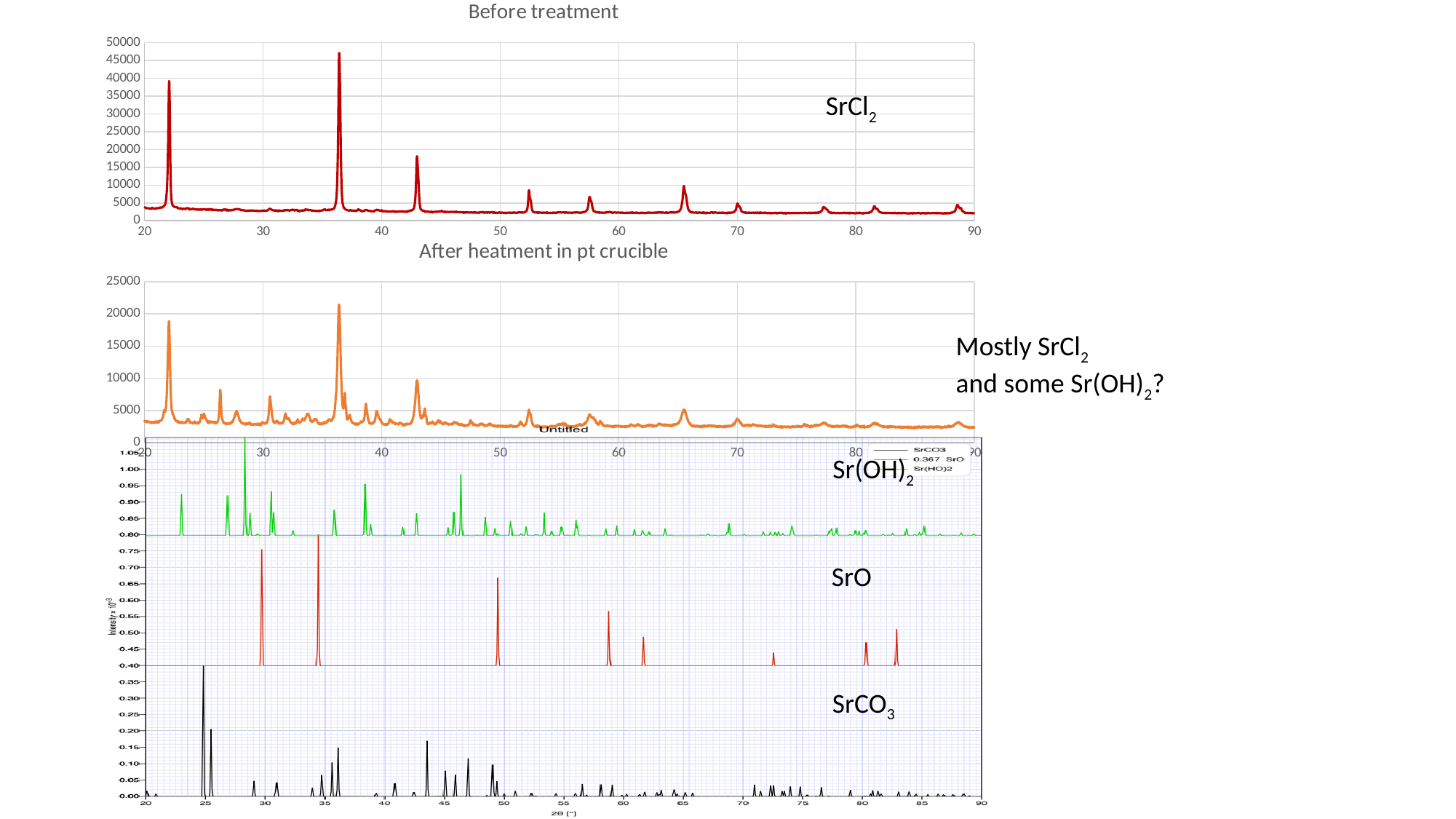
What is the title of the top chart on the slide? Before treatment In the bottom reference-pattern chart, how many compounds are listed in the legend? 3 In the 'After heatment in pt crucible' chart, is the value of the peak near 22 on the x axis greater or less than 20000? less In the 'Before treatment' chart, which peak is taller: the one near 22 or the one near 36 on the x axis? the one near 36 In the 'After heatment in pt crucible' chart, is the value of the tallest peak (near 36 on the x axis) greater or less than 20000? greater In the 'Before treatment' chart, is the value of the peak near 22 on the x axis greater or less than 35000? greater In the 'After heatment in pt crucible' chart, which peak is taller: the one near 22 or the one near 36 on the x axis? the one near 36 In the 'Before treatment' chart, what kind of chart is shown? line chart What is the title of the middle chart on the slide? After heatment in pt crucible